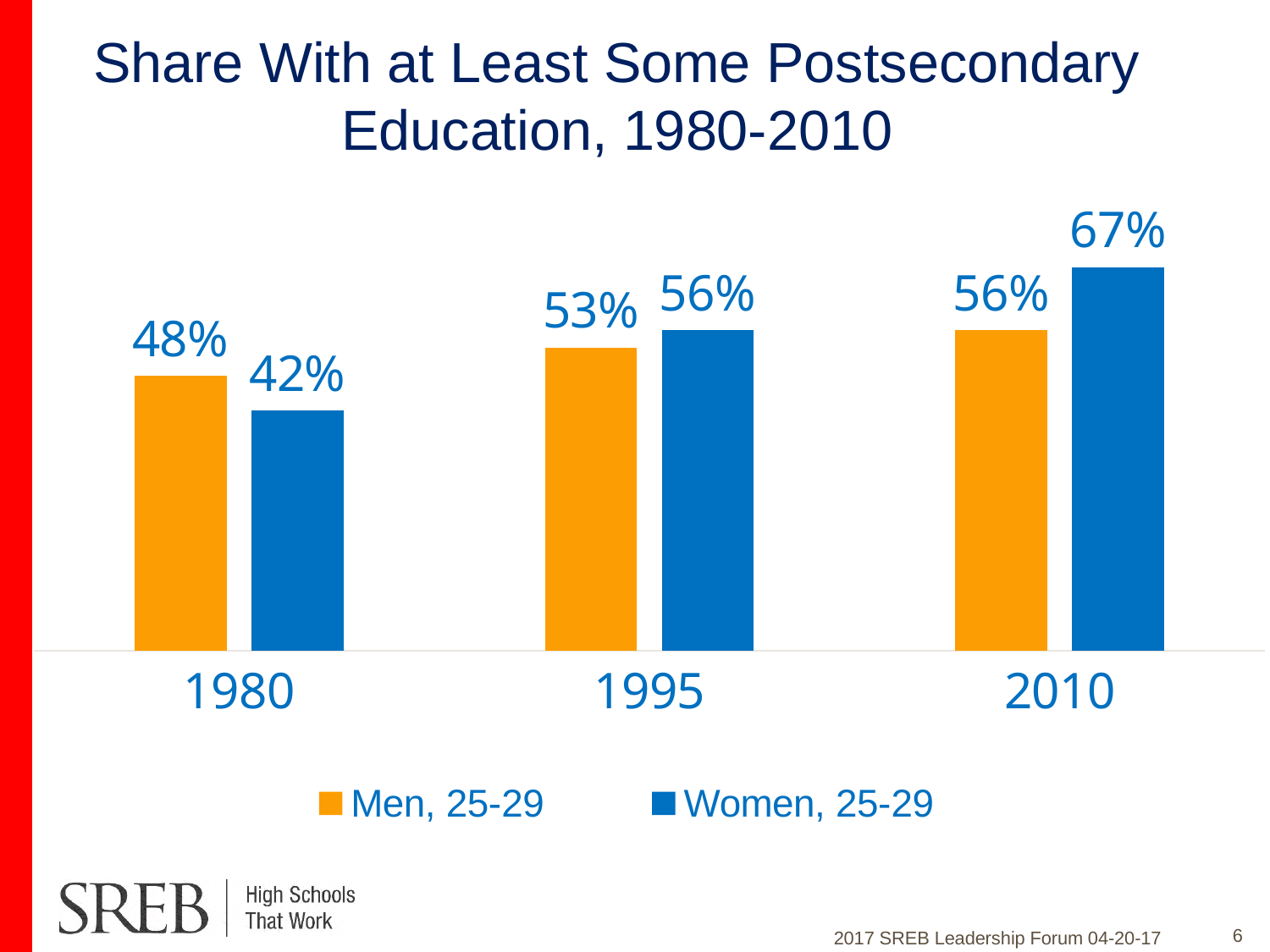
In 1980, which is larger: the value for Men, 25-29 or Women, 25-29? Men, 25-29 How many series does the legend list? 2 What kind of chart is shown on the slide? Bar chart What is the value for Men, 25-29 in 1980? 48% How many years are shown on the x axis? 3 In which year is the value for Women, 25-29 highest? 2010 What is the value for Women, 25-29 in 2010? 67% What is the difference between the Women, 25-29 and Men, 25-29 values in 2010? 11% What is the value for Women, 25-29 in 1995? 56% Do the values for Women, 25-29 rise or fall from 1980 to 2010? Rise In which year is the value for Men, 25-29 lowest? 1980 What is the value for Men, 25-29 in 2010? 56%